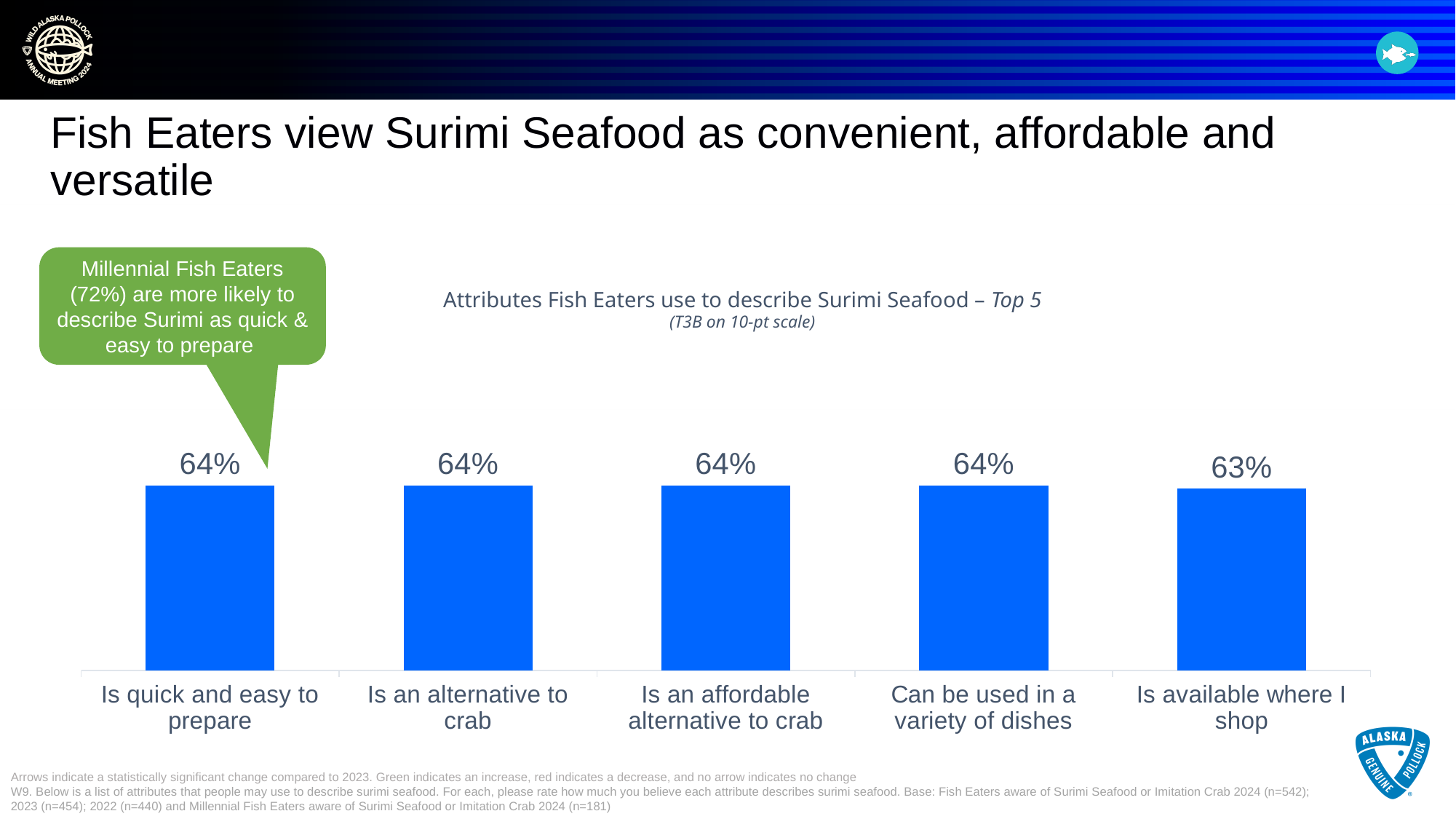
What is the title of the chart? Attributes Fish Eaters use to describe Surimi Seafood – Top 5 What is the value for "Is available where I shop"? 63% Which is larger: the value for "Is an alternative to crab" or the value for "Is available where I shop"? Is an alternative to crab What is the value for "Can be used in a variety of dishes"? 64% According to the callout, what percentage of Millennial Fish Eaters describe Surimi as quick and easy to prepare? 72% What is the value for "Is an affordable alternative to crab"? 64% What kind of chart is shown on the slide? Bar chart Which attribute has the lowest value in the chart? Is available where I shop Do the values rise or fall from the first bar to the last bar? Fall How many attributes are shown in the chart? 5 What percentage of Fish Eaters describe Surimi Seafood as quick and easy to prepare? 64% What is the difference between the value for "Is quick and easy to prepare" and the value for "Is available where I shop"? 1 percentage point